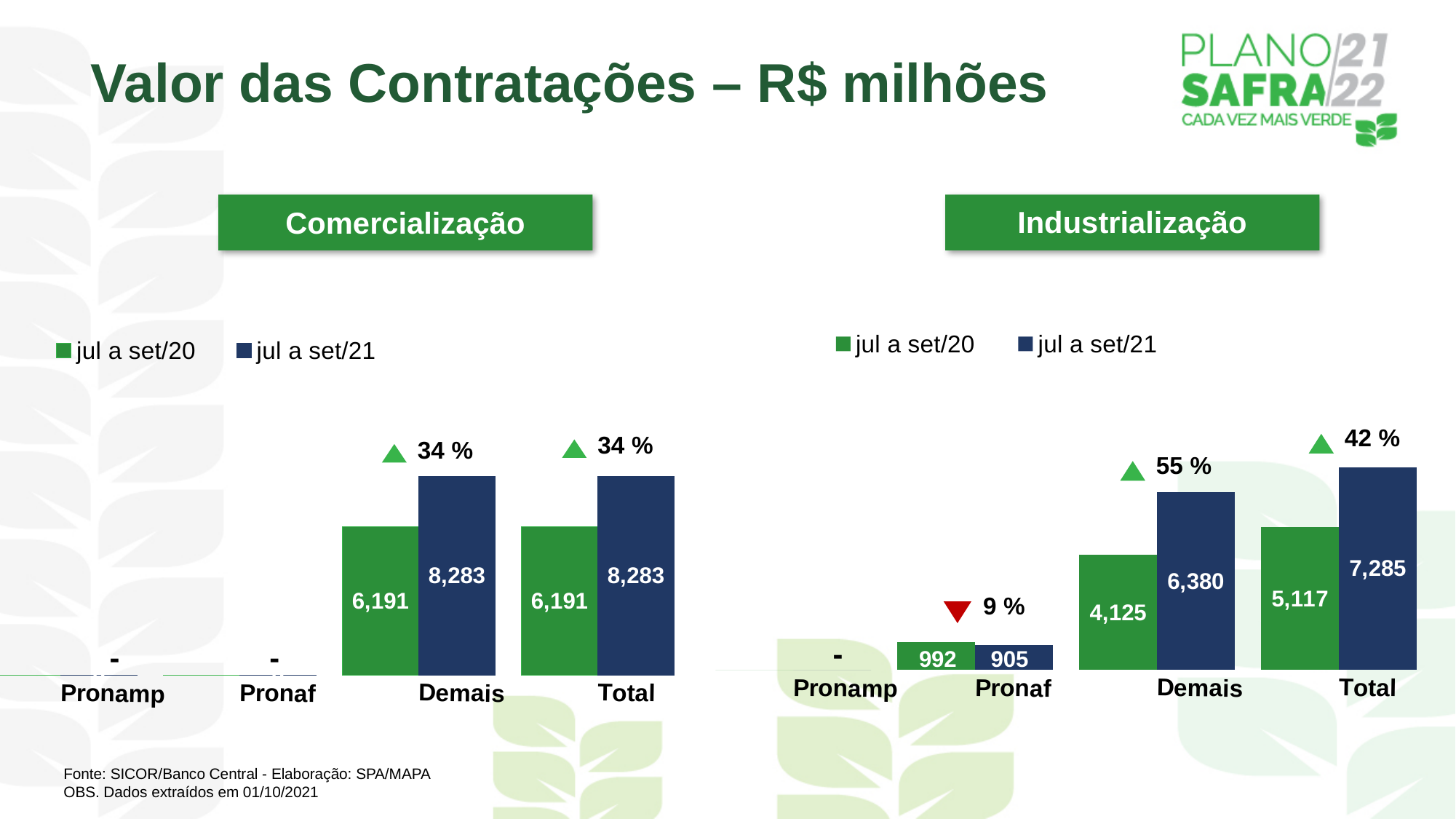
In the Comercialização chart, what is the value for Demais in jul a set/21? 8,283 In the Industrialização chart, what is the value for Total in jul a set/21? 7,285 In the Industrialização chart, which is larger for Pronaf: jul a set/20 or jul a set/21? jul a set/20 In the Industrialização chart, what is the value for Demais in jul a set/21? 6,380 In the Industrialização chart, what is the value for Pronaf in jul a set/20? 992 What kind of chart is the Comercialização chart? Bar chart In the Industrialização chart, what is the difference between the jul a set/21 and jul a set/20 values for Demais? 2,255 In the Industrialização chart, what percentage change is shown above the Total bars? 42 % In the Industrialização chart, which category has the highest value for jul a set/21? Total How many series does the legend of the Comercialização chart list? 2 How many categories are shown on the x axis of the Industrialização chart? 4 In the Comercialização chart, what is the value for Total in jul a set/20? 6,191